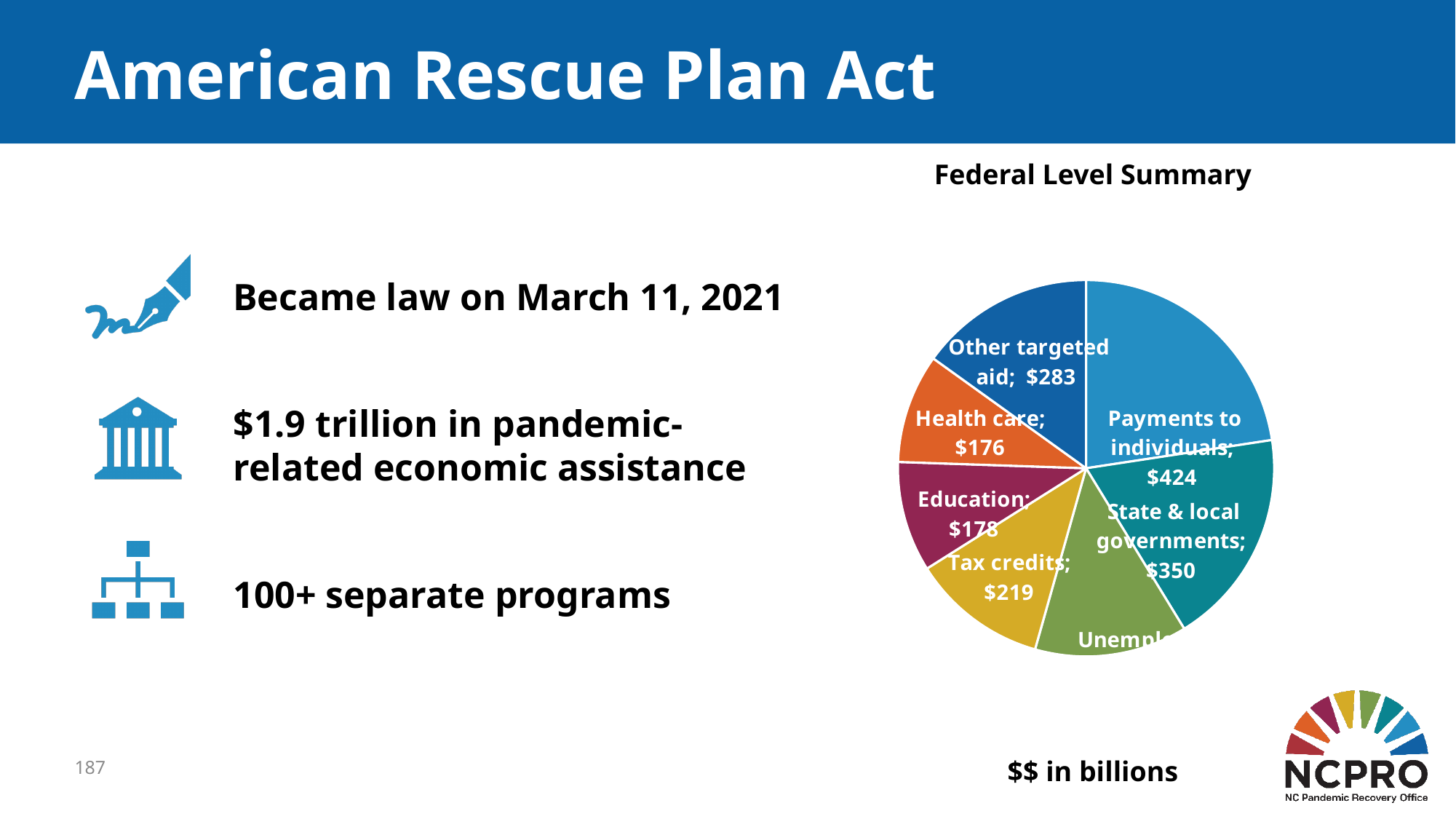
How much larger is Payments to individuals than State & local governments? $74 What is the difference between Other targeted aid and Tax credits? $64 What is the value for Tax credits? $219 What is the title of the chart? Federal Level Summary Which is larger, Other targeted aid or Tax credits? Other targeted aid Which category has the largest slice of the pie? Payments to individuals What is the value for Payments to individuals? $424 In what units are the chart values expressed, according to the note below the chart? $$ in billions What is the value for State & local governments? $350 What kind of chart is shown on the slide? pie chart What is the value for Other targeted aid? $283 What is the value for Health care? $176